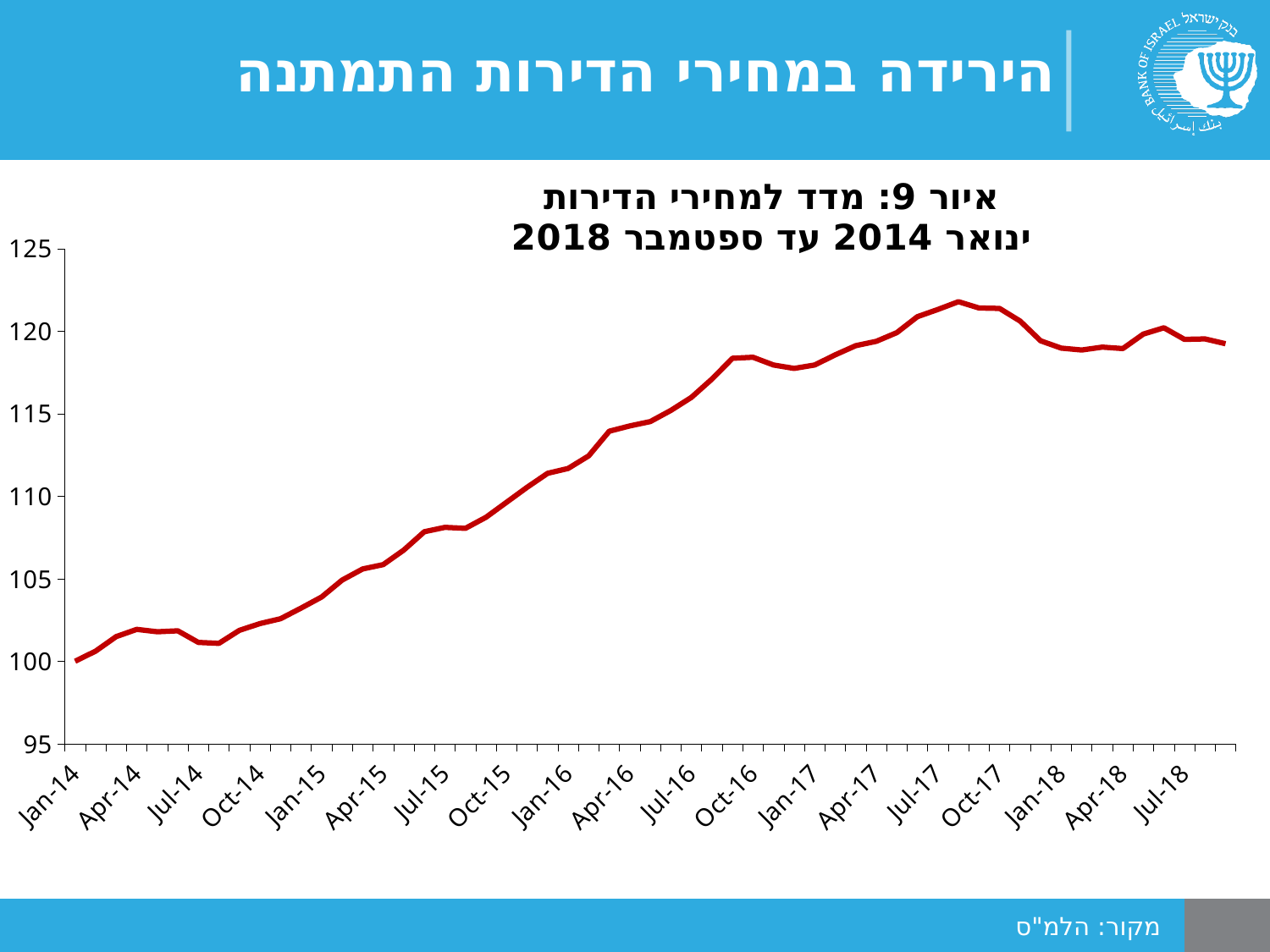
Is the value for Jan-15 greater or less than 105? less Overall, does the index rise or fall from Jan-14 to the end of the series? rise Which is larger, the value for Jan-16 or the value for Jan-17? Jan-17 Is the value for Jan-18 greater or less than 120? less Is the value for Oct-16 greater or less than 115? greater Which month has the lowest value on the chart? Jan-14 What is the value of the index at Jan-14? 100 What kind of chart is shown on the slide? line chart Which is larger, the value for Jul-17 or the value for Jan-18? Jul-17 What colour is the line plotted on the chart? red